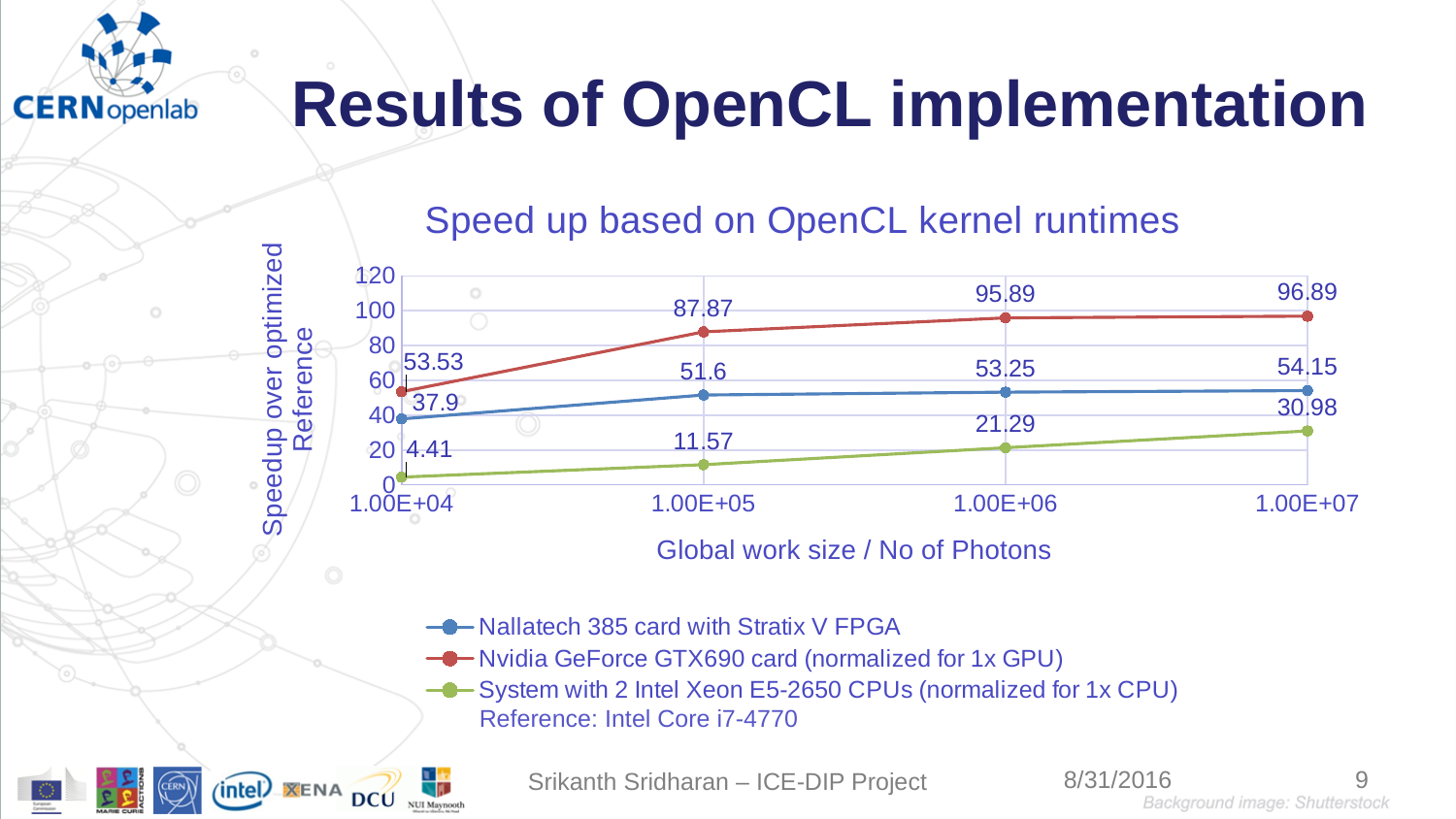
Which series has the larger speedup at a global work size of 1.00E+04: the Nallatech 385 card or the Nvidia GeForce GTX690 card? Nvidia GeForce GTX690 card At which global work size does the Nvidia GeForce GTX690 card reach its highest speedup? 1.00E+07 How many global work size values are plotted on the x axis? 4 At which global work size is the speedup for the System with 2 Intel Xeon E5-2650 CPUs lowest? 1.00E+04 What is the difference between the Nvidia GeForce GTX690 speedup and the Nallatech 385 speedup at a global work size of 1.00E+06? 42.64 How many series does the legend list? 3 Does the speedup for the System with 2 Intel Xeon E5-2650 CPUs rise or fall as the global work size increases? rise What is the speedup for the Nvidia GeForce GTX690 card at a global work size of 1.00E+05? 87.87 What kind of chart is shown on the slide? line chart What is the speedup for the System with 2 Intel Xeon E5-2650 CPUs at a global work size of 1.00E+04? 4.41 What is the speedup for the Nallatech 385 card with Stratix V FPGA at a global work size of 1.00E+07? 54.15 Is the speedup for the Nvidia GeForce GTX690 card at 1.00E+07 greater or less than 100? less